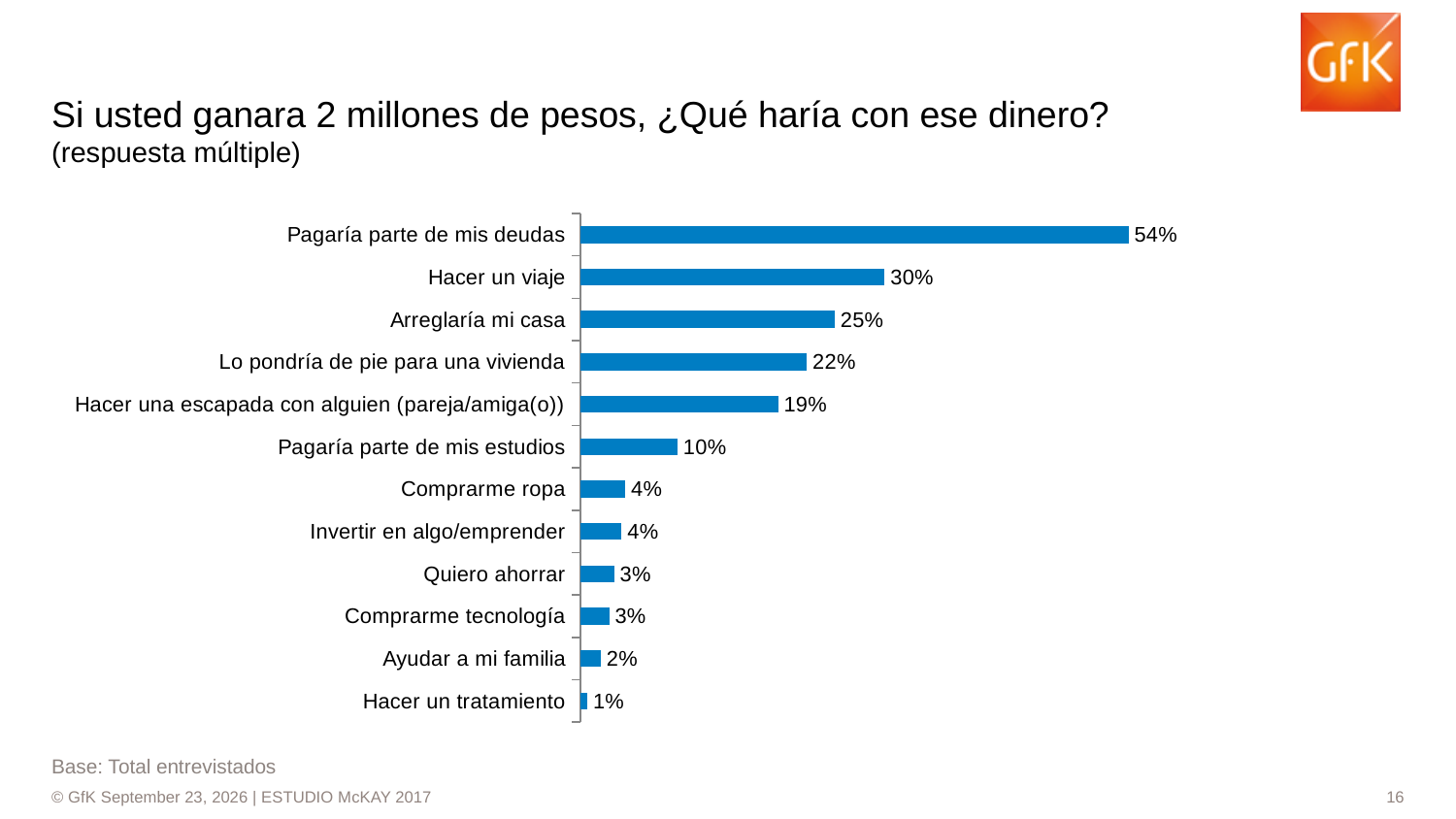
Which category has the lowest value? Hacer un tratamiento Which category has the highest value? Pagaría parte de mis deudas What percentage of respondents said they would pay part of their debts (Pagaría parte de mis deudas)? 54% How many categories are shown in the chart? 12 What is the base of respondents stated below the chart? Total entrevistados What is the difference between 'Pagaría parte de mis deudas' and 'Hacer un viaje'? 24% What is the value for 'Pagaría parte de mis estudios'? 10% Which is larger, 'Arreglaría mi casa' or 'Lo pondría de pie para una vivienda'? Arreglaría mi casa What kind of chart is shown on the slide? Bar chart What is the value for 'Lo pondría de pie para una vivienda'? 22% What is the difference between 'Arreglaría mi casa' and 'Hacer una escapada con alguien (pareja/amiga(o))'? 6% What is the value for 'Hacer un viaje'? 30%